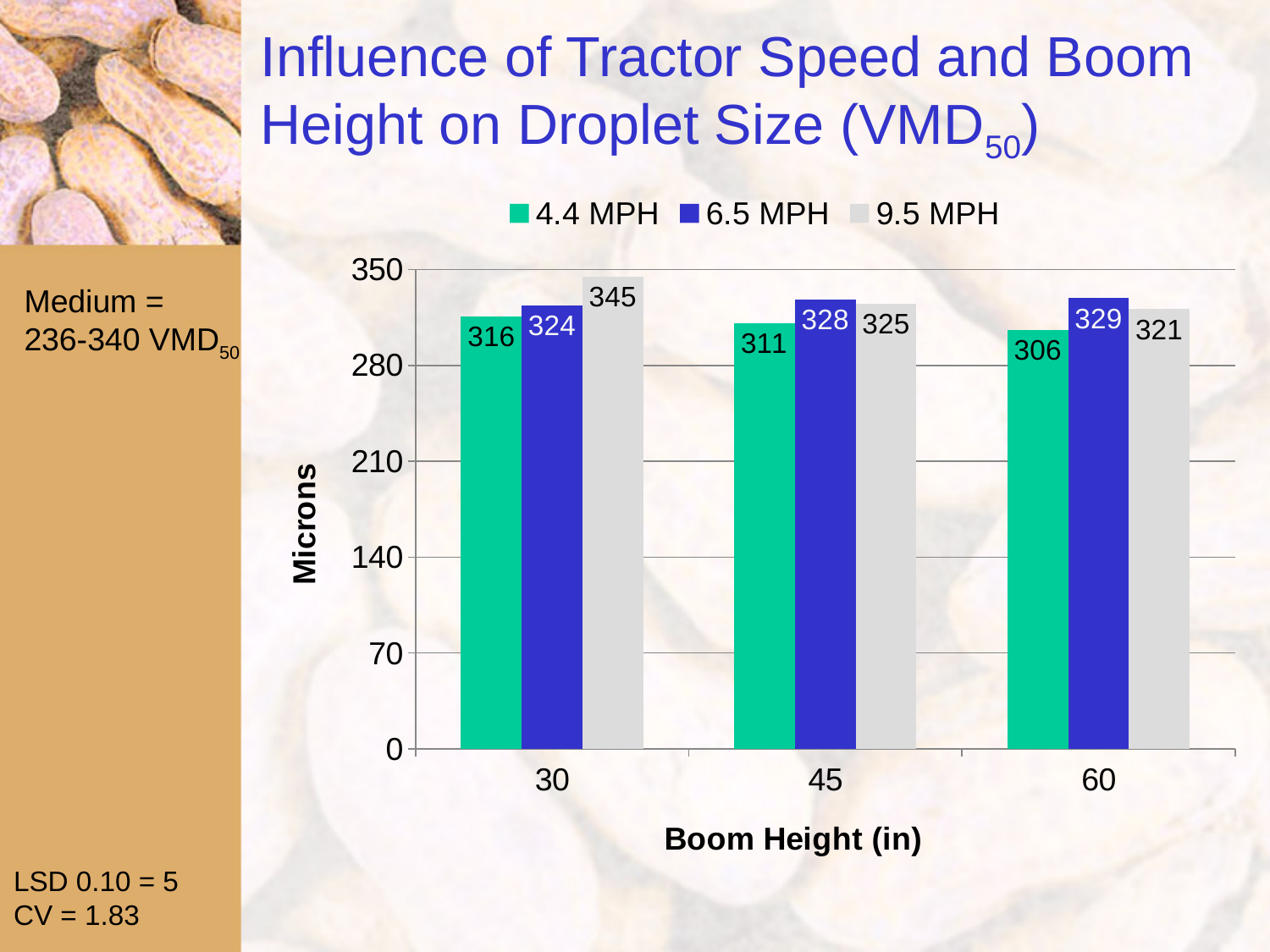
Do the 4.4 MPH values rise or fall as boom height increases from 30 to 60 in? fall What is the droplet size in microns for 6.5 MPH at a boom height of 60 in? 329 At a boom height of 45 in, which is larger: the 6.5 MPH value or the 4.4 MPH value? 6.5 MPH What kind of chart is shown on the slide? bar chart How many boom height categories are shown on the x axis? 3 What is the difference in microns between the 9.5 MPH and 4.4 MPH values at a boom height of 30 in? 29 Which boom height has the highest droplet size for the 9.5 MPH series? 30 What is the droplet size in microns for 9.5 MPH at a boom height of 45 in? 325 What is the droplet size in microns for 4.4 MPH at a boom height of 30 in? 316 Which boom height has the lowest droplet size for the 4.4 MPH series? 60 How many series does the legend list? 3 Is the value for 4.4 MPH at a boom height of 60 in greater or less than 280? greater